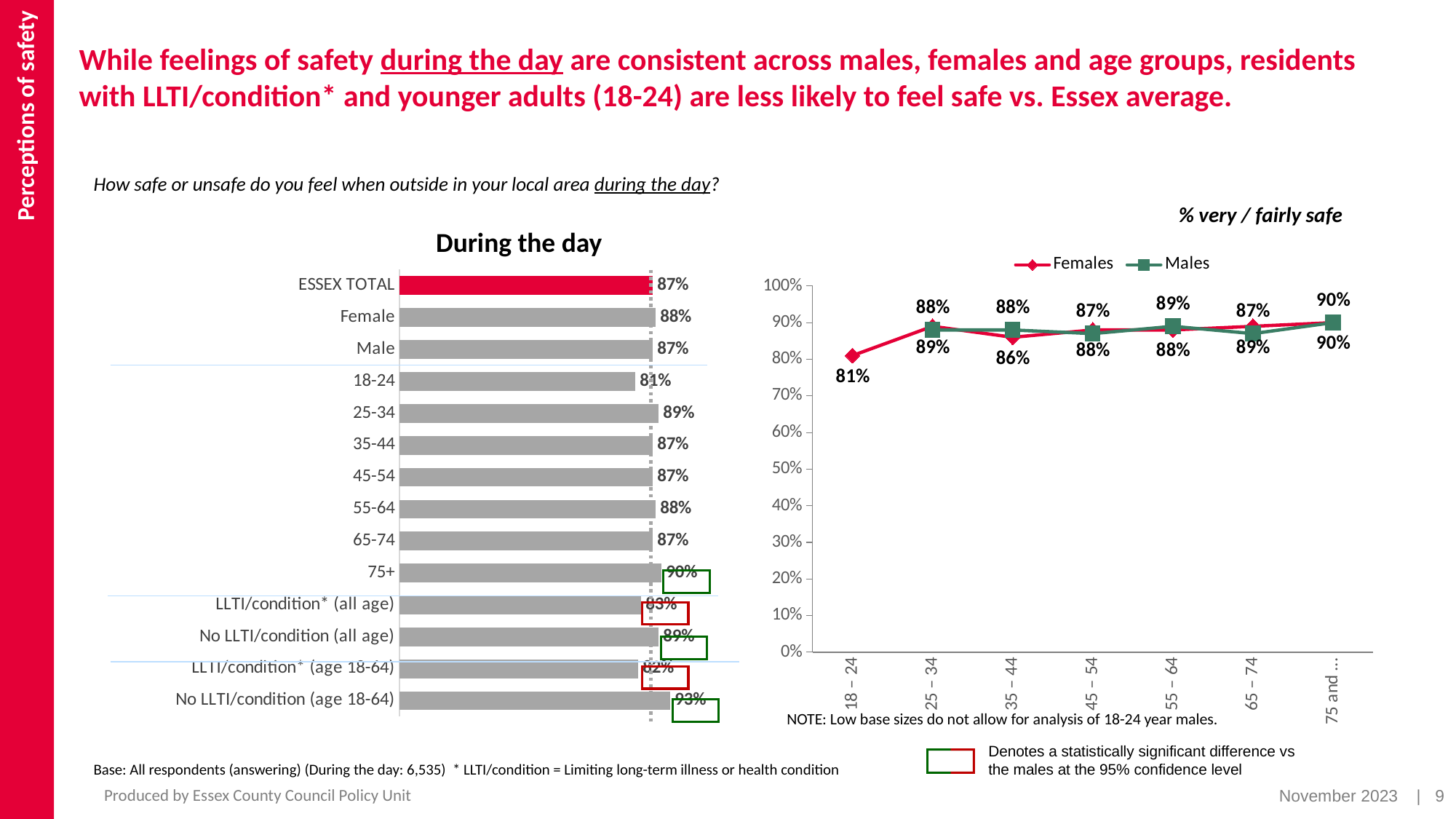
In the 'During the day' bar chart, what is the value for 18-24? 81% In the 'During the day' bar chart, which age group between 18-24 and 65-74 has the lowest value? 18-24 In the 'During the day' bar chart, what is the value for Female? 88% How many series does the legend of the line chart on the right list? 2 In the 'During the day' bar chart, which is larger, the value for 25-34 or the value for 18-24? 25-34 In the 'During the day' bar chart, what is the value for ESSEX TOTAL? 87% In the 'During the day' bar chart, how many bars are plotted? 14 What kind of chart is the 'During the day' chart on the left of the slide? bar chart In the 'During the day' bar chart, what is the difference between the Female and Male values? 1 percentage point In the line chart on the right, what is the Females value for the 18 – 24 age group? 81% What kind of chart is the chart on the right of the slide showing Females and Males by age group? line chart In the 'During the day' bar chart, what is the value for 25-34? 89%